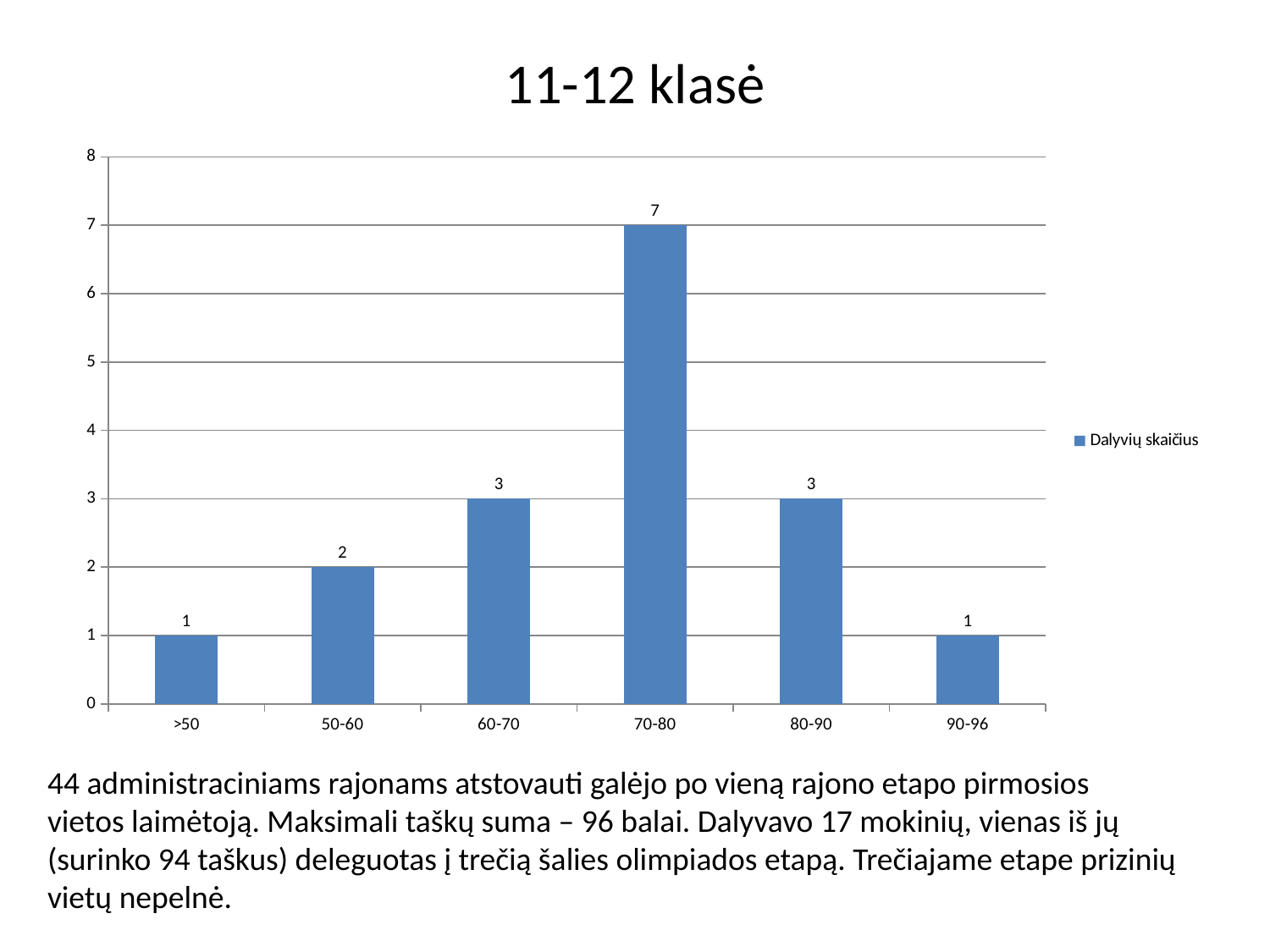
What is the difference between the values for 70-80 and 80-90? 4 What is the title of the chart? 11-12 klasė What is the value for the 50-60 category? 2 Is the value for 70-80 greater or less than 5? greater How many categories are shown on the x axis? 6 What kind of chart is shown on the slide? bar chart Which is larger, the value for 50-60 or the value for 80-90? 80-90 What is the value for the >50 category? 1 Which category has the highest value? 70-80 What is the value for the 70-80 category? 7 How many series does the legend list? 1 What is the difference between the values for 60-70 and 50-60? 1